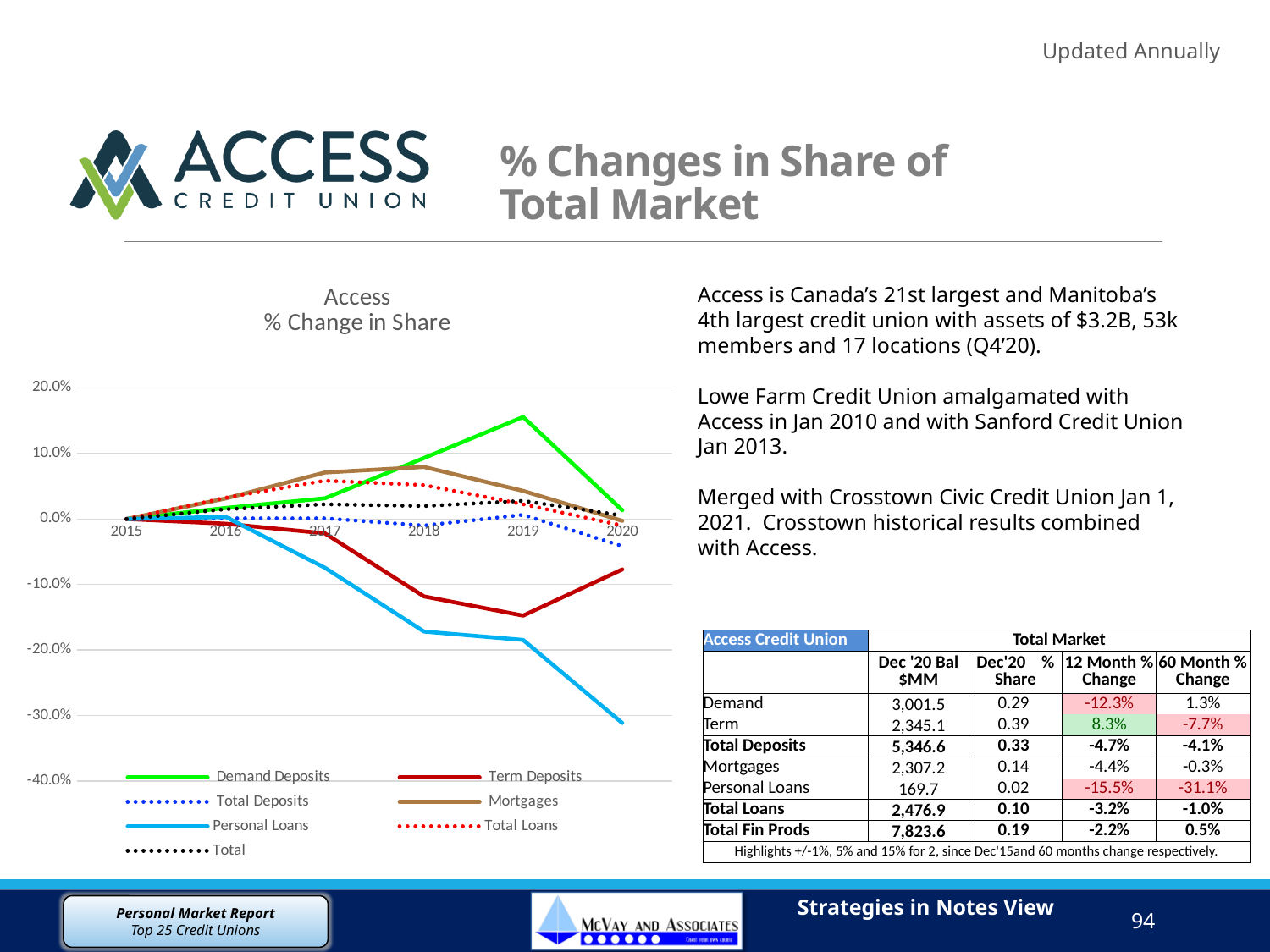
What kind of chart is shown on the slide? line chart In 2020, which is larger: Demand Deposits or Term Deposits? Demand Deposits Is the value for Demand Deposits in 2019 greater or less than 10.0%? greater How many series does the chart legend list? 7 How many years are plotted along the x axis of the chart? 6 What is the title of the chart? Access % Change in Share Does the Personal Loans series rise or fall from 2015 to 2020? fall Is the value for Personal Loans in 2020 greater or less than -20.0%? less Is the value for Mortgages in 2018 greater or less than 0.0%? greater Which series has the lowest value in 2020? Personal Loans Which series has the highest value in 2019? Demand Deposits